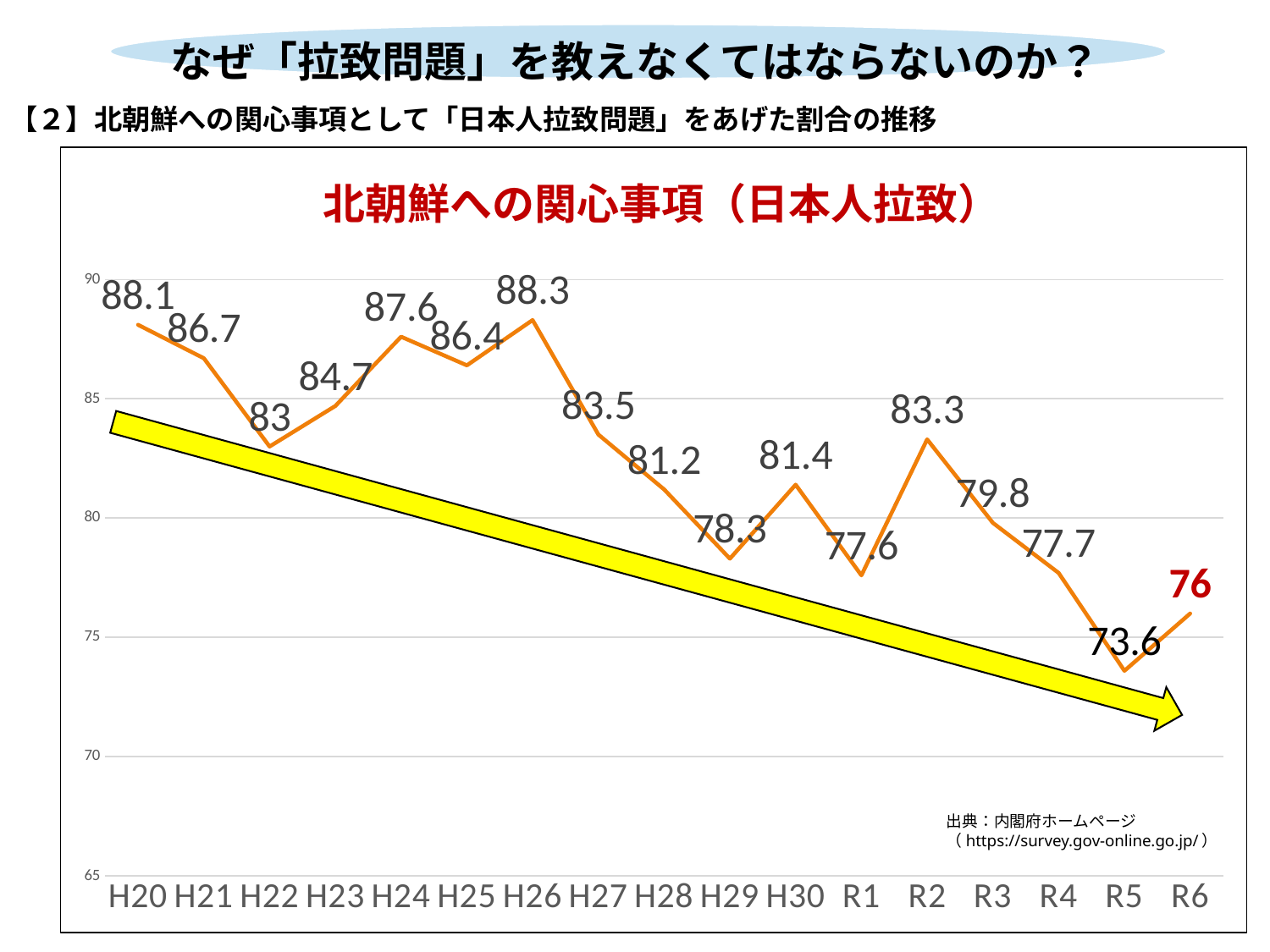
How many data points are plotted on the chart? 17 What is the value for R5? 73.6 What is the value for R6? 76 What is the value for H20? 88.1 Which year has the highest value? H26 Which year has the lowest value? R5 Do the values generally rise or fall from H20 to R6? fall Is the value for R2 greater or less than 80? greater What is the value for H26? 88.3 What kind of chart is shown? line chart What is the difference between the values for H20 and R6? 12.1 Which is larger, the value for H30 or the value for R1? H30